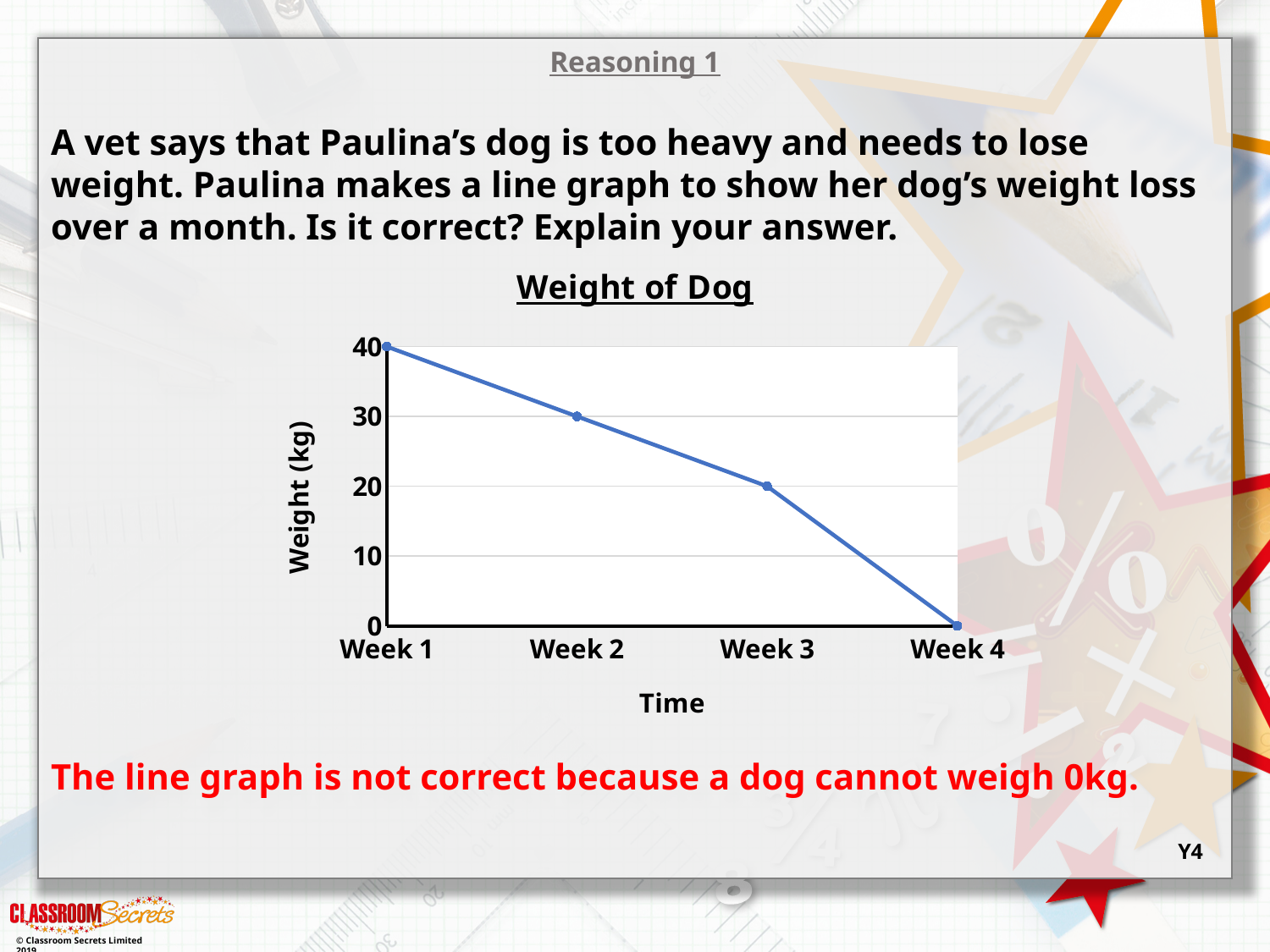
What is the dog's weight in Week 3? 20 kg What kind of chart is shown on the slide? line chart What is the dog's weight in Week 4? 0 kg What is the dog's weight in Week 2? 30 kg In which week is the dog's weight lowest? Week 4 What is the dog's weight in Week 1? 40 kg In which week is the dog's weight highest? Week 1 How much weight did the dog lose between Week 1 and Week 3? 20 kg What is the title of the chart? Weight of Dog Does the dog's weight rise or fall from Week 1 to Week 4? fall How many weeks are plotted on the chart? 4 Which is larger, the weight in Week 2 or the weight in Week 3? Week 2